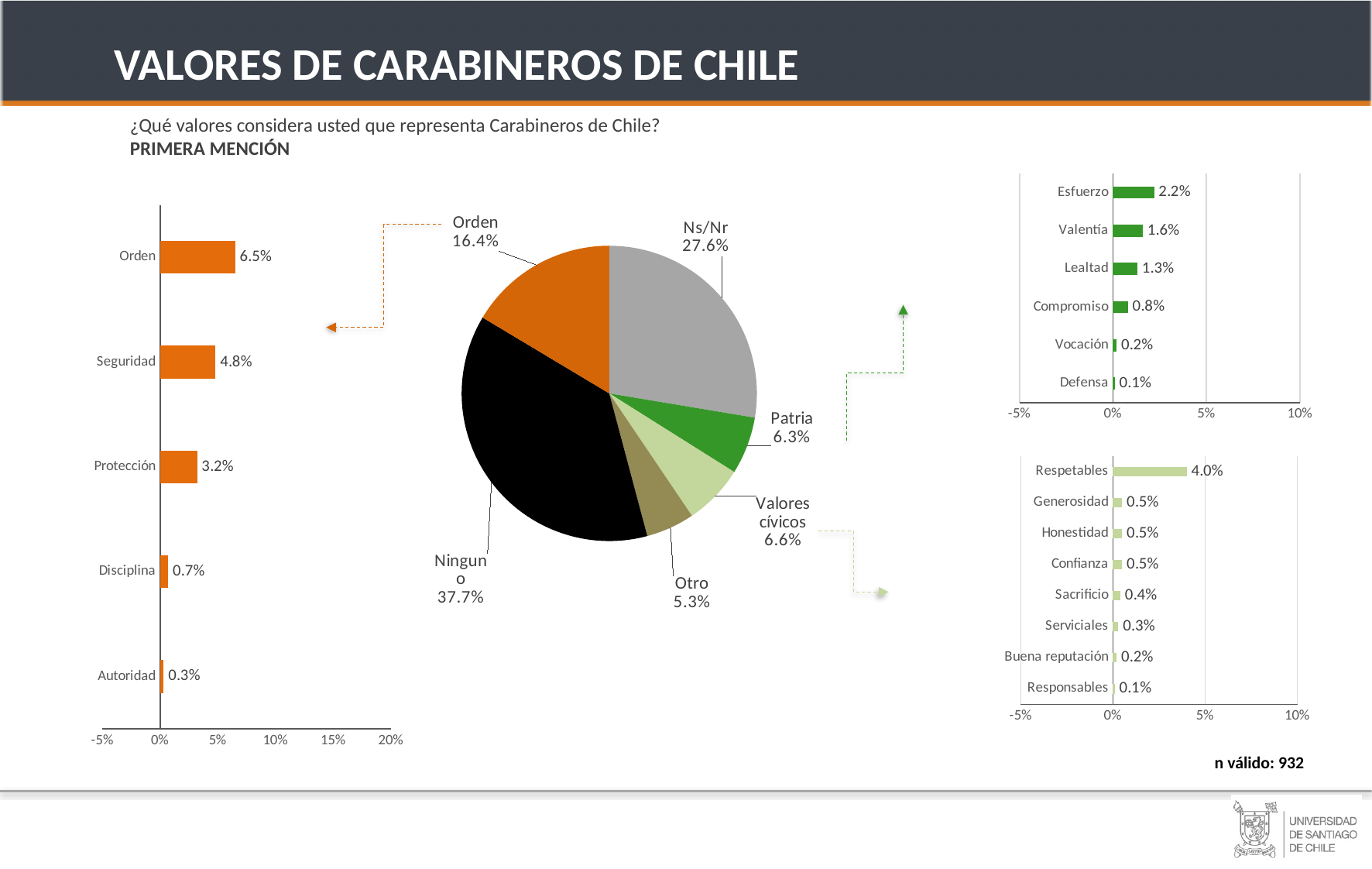
In the pie chart in the centre of the slide, which slice is the smallest? Otro In the orange bar chart on the left of the slide, what is the difference between Orden and Protección? 3.3% In the light green bar chart at the bottom right of the slide, how many categories are shown? 8 In the pie chart in the centre of the slide, how many slices are there? 6 In the orange bar chart on the left of the slide, is the value for Orden greater or less than 5%? greater In the pie chart in the centre of the slide, which slice is the largest? Ninguno In the green bar chart at the top right of the slide, what is the value for Lealtad? 1.3% In the light green bar chart at the bottom right of the slide, which is larger, Respetables or Sacrificio? Respetables In the orange bar chart on the left of the slide, which category has the lowest value? Autoridad In the orange bar chart on the left of the slide, what is the value for Seguridad? 4.8% In the green bar chart at the top right of the slide, which category has the highest value? Esfuerzo In the pie chart in the centre of the slide, what share is labelled for Ninguno? 37.7%